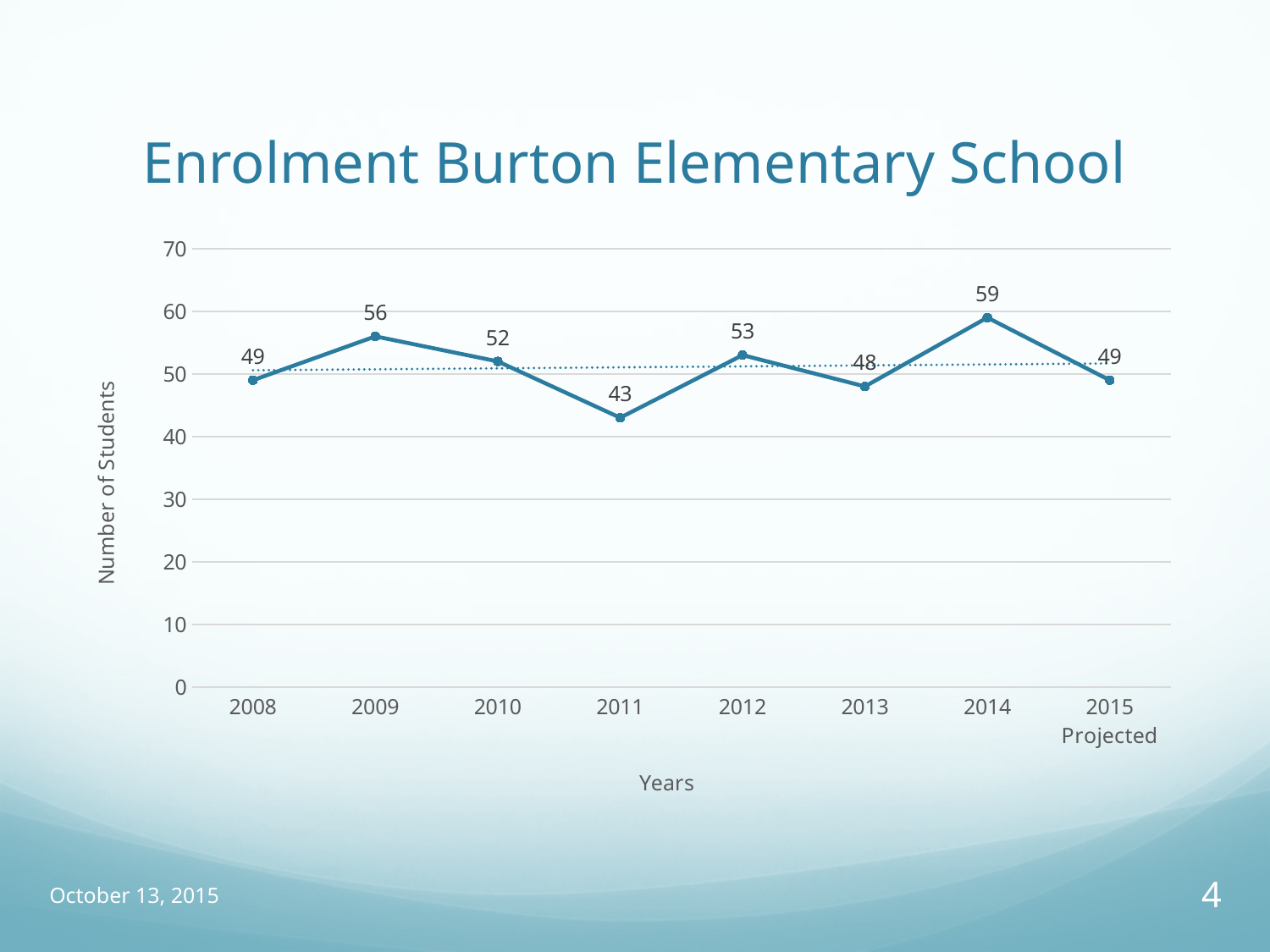
What is the projected number of students for 2015? 49 Which year has more students, 2012 or 2013? 2012 What is the number of students in 2009? 56 What is the difference in the number of students between 2009 and 2008? 7 How many years are plotted on the x axis? 8 What is the title of the chart? Enrolment Burton Elementary School What is the difference in the number of students between 2014 and 2011? 16 What kind of chart is shown on the slide? line chart Which year has the lowest number of students? 2011 What is the number of students in 2011? 43 Does the number of students rise or fall from 2013 to 2014? rise Which year has the highest number of students? 2014